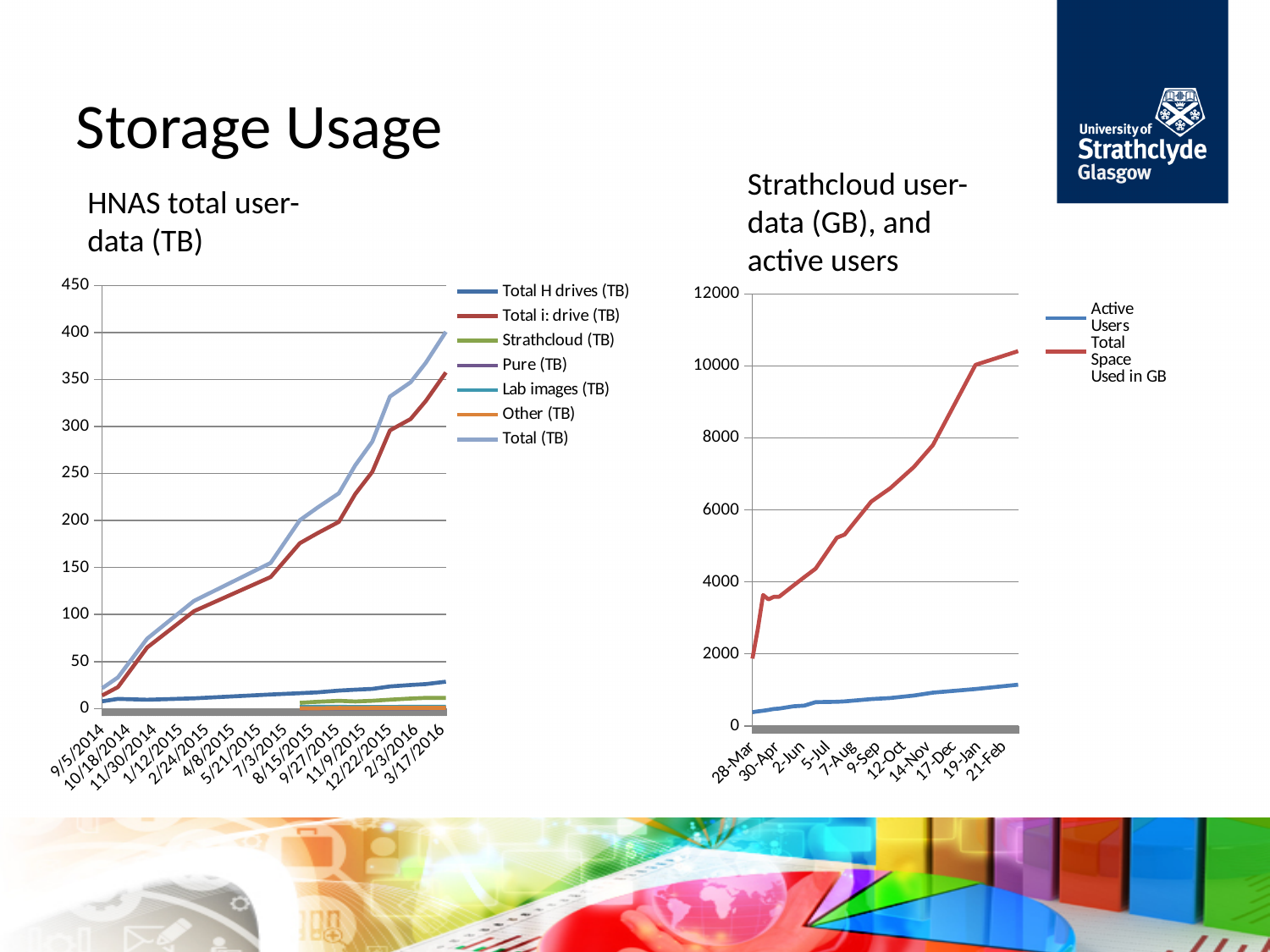
In the 'HNAS total user-data (TB)' chart, is the value of 'Total H drives (TB)' at 3/17/2016 greater or less than 50? less In the 'Strathcloud user-data (GB), and active users' chart, is the value of 'Active Users' at 21-Feb greater or less than 2000? less In the 'HNAS total user-data (TB)' chart, does the 'Total (TB)' series rise or fall from 9/5/2014 to 3/17/2016? rise In the 'Strathcloud user-data (GB), and active users' chart, is the value of 'Total Space Used in GB' at 21-Feb greater or less than 10000? greater What kind of chart is the 'HNAS total user-data (TB)' chart on the left? line chart In the 'Strathcloud user-data (GB), and active users' chart, does the 'Total Space Used in GB' series rise or fall from 28-Mar to 21-Feb? rise How many series does the legend of the 'HNAS total user-data (TB)' chart list? 7 What kind of chart is the 'Strathcloud user-data (GB), and active users' chart on the right? line chart How many series does the legend of the 'Strathcloud user-data (GB), and active users' chart list? 2 In the 'HNAS total user-data (TB)' chart, which is larger at 3/17/2016: 'Total i: drive (TB)' or 'Total H drives (TB)'? Total i: drive (TB) What is the title of the chart on the left of the slide? HNAS total user-data (TB)